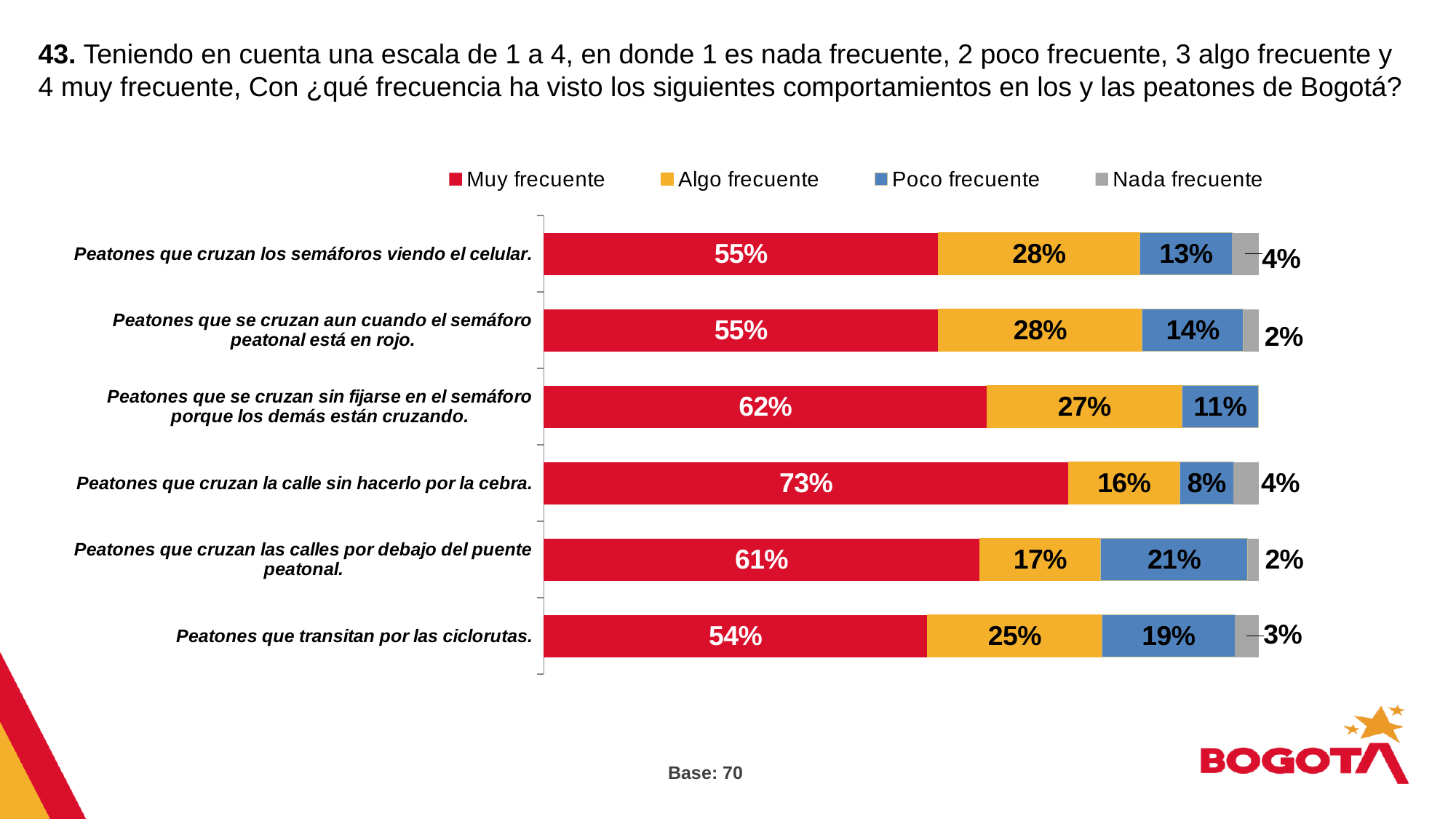
What is the 'Poco frecuente' value for 'Peatones que cruzan las calles por debajo del puente peatonal'? 21% What is the total of the stacked bar for 'Peatones que cruzan los semáforos viendo el celular'? 100% What kind of chart is shown on the slide? Stacked bar chart What is the 'Algo frecuente' value for 'Peatones que transitan por las ciclorutas'? 25% How many series does the legend list? 4 Which legend entry is shown in red? Muy frecuente Which category has the highest 'Muy frecuente' value? Peatones que cruzan la calle sin hacerlo por la cebra. What is the 'Muy frecuente' value for 'Peatones que cruzan la calle sin hacerlo por la cebra'? 73% Which category has the lowest 'Muy frecuente' value? Peatones que transitan por las ciclorutas. How many categories (behaviours) are plotted in the chart? 6 What is the difference between the 'Muy frecuente' values for 'Peatones que cruzan la calle sin hacerlo por la cebra' and 'Peatones que transitan por las ciclorutas'? 19% Which is larger: the 'Poco frecuente' value for 'Peatones que cruzan las calles por debajo del puente peatonal' or for 'Peatones que cruzan los semáforos viendo el celular'? Peatones que cruzan las calles por debajo del puente peatonal.